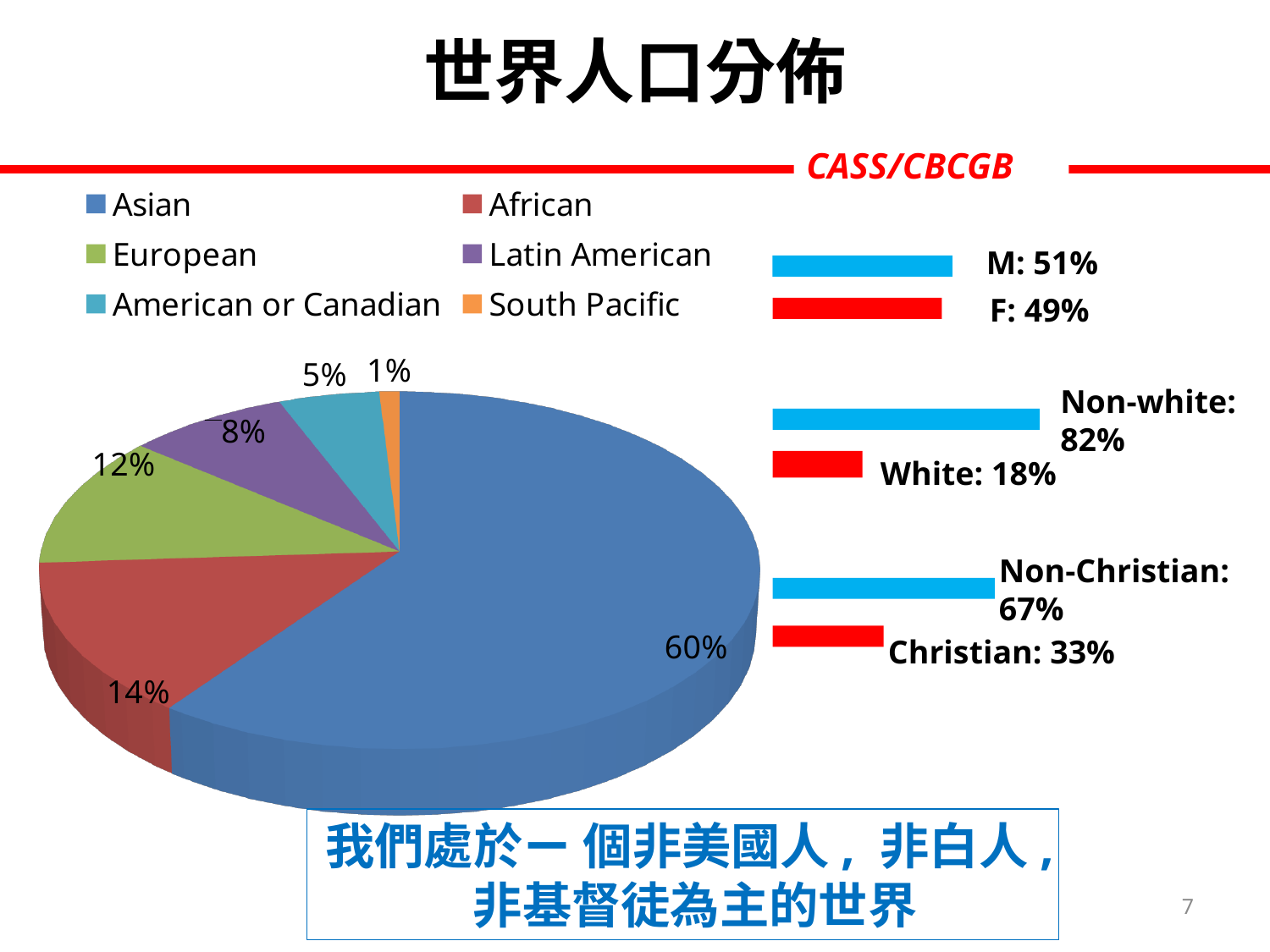
Which category has the smallest slice of the pie chart? South Pacific What share of the pie chart is Latin American? 8% What is the difference between the Asian and African shares in the pie chart? 46% What kind of chart is shown on the slide? pie chart What share of the pie chart is African? 14% What share of the pie chart is Asian? 60% What share of the pie chart is South Pacific? 1% Which category has the largest slice of the pie chart? Asian How many categories does the pie chart's legend list? 6 Which is larger in the pie chart, European or Latin American? European What share of the pie chart is European? 12% What share of the pie chart is American or Canadian? 5%